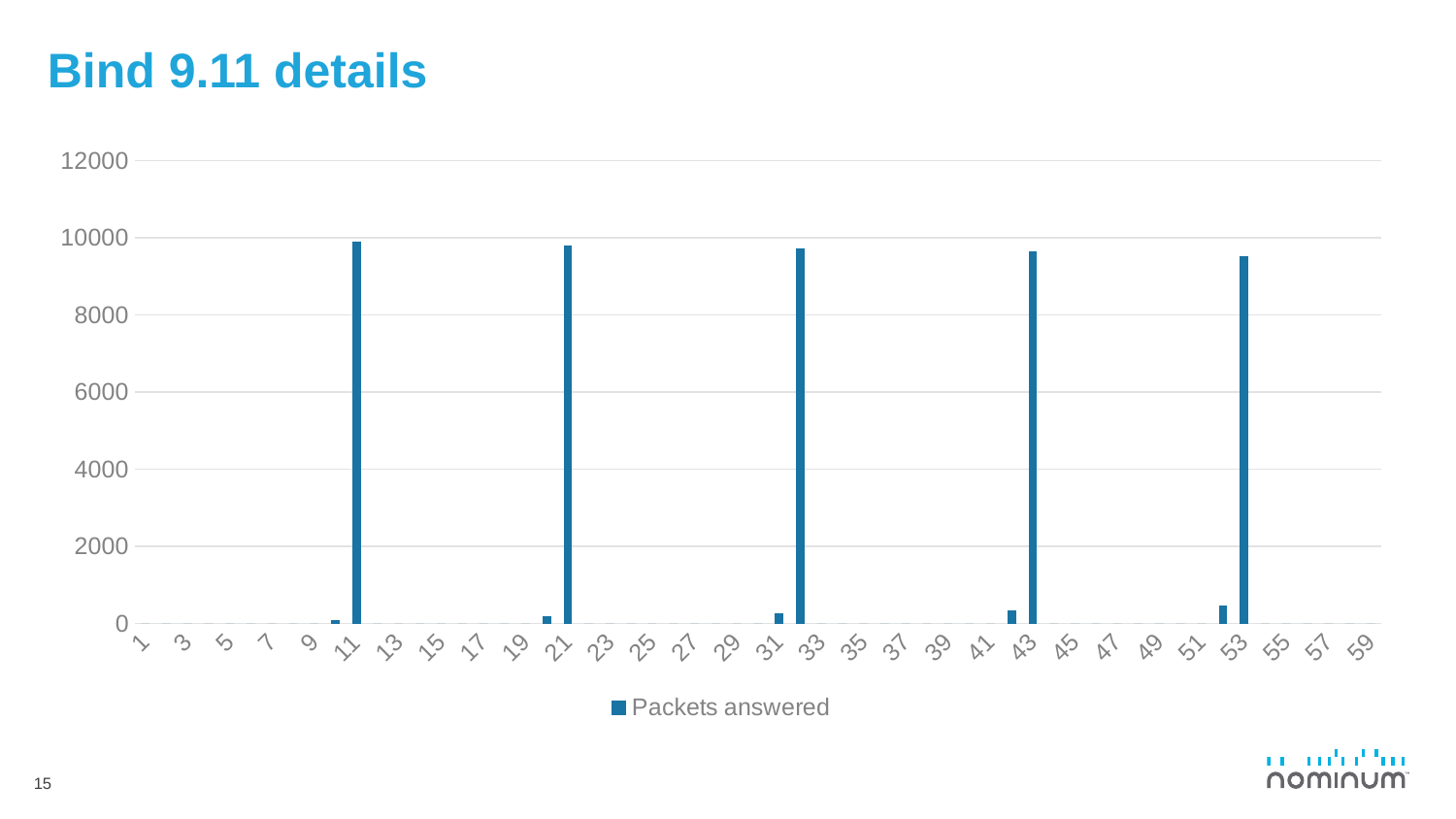
What is the highest value shown on the y axis? 12000 Is the value for category 19 greater or less than 2000? less Which has the larger value, category 11 or category 9? 11 Is the value for category 21 greater or less than 8000? greater What is the name of the series shown in the legend? Packets answered What kind of chart is shown on the slide? bar chart Which has the larger value, category 21 or category 19? 21 Is the value for category 11 greater or less than 8000? greater What is the title of the slide containing the chart? Bind 9.11 details How many series does the legend list? 1